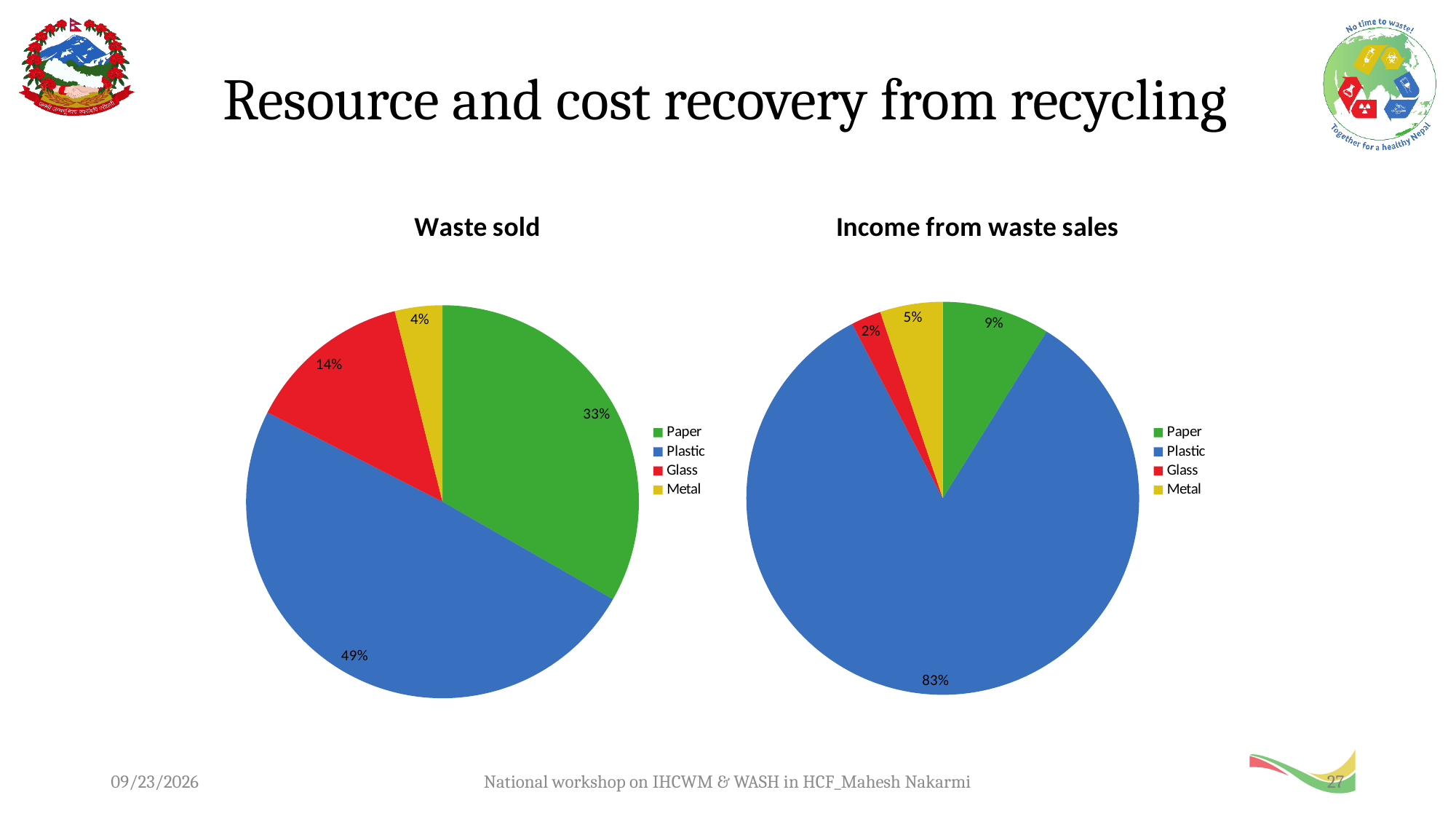
In the 'Waste sold' chart, which category has the largest slice? Plastic In the 'Income from waste sales' chart, which is larger, the Metal slice or the Glass slice? Metal In the 'Income from waste sales' chart, which category has the smallest slice? Glass In the 'Waste sold' chart, what is the difference between the Paper and Glass shares? 19% In the 'Waste sold' chart, what share does Plastic have? 49% In the 'Waste sold' chart, which colour represents Glass in the legend? Red What type of chart is the 'Income from waste sales' chart? Pie chart How many categories does the 'Waste sold' chart show? 4 In the 'Income from waste sales' chart, what share does Plastic have? 83% In the 'Waste sold' chart, which category has the smallest slice? Metal In the 'Waste sold' chart, what share does Glass have? 14%